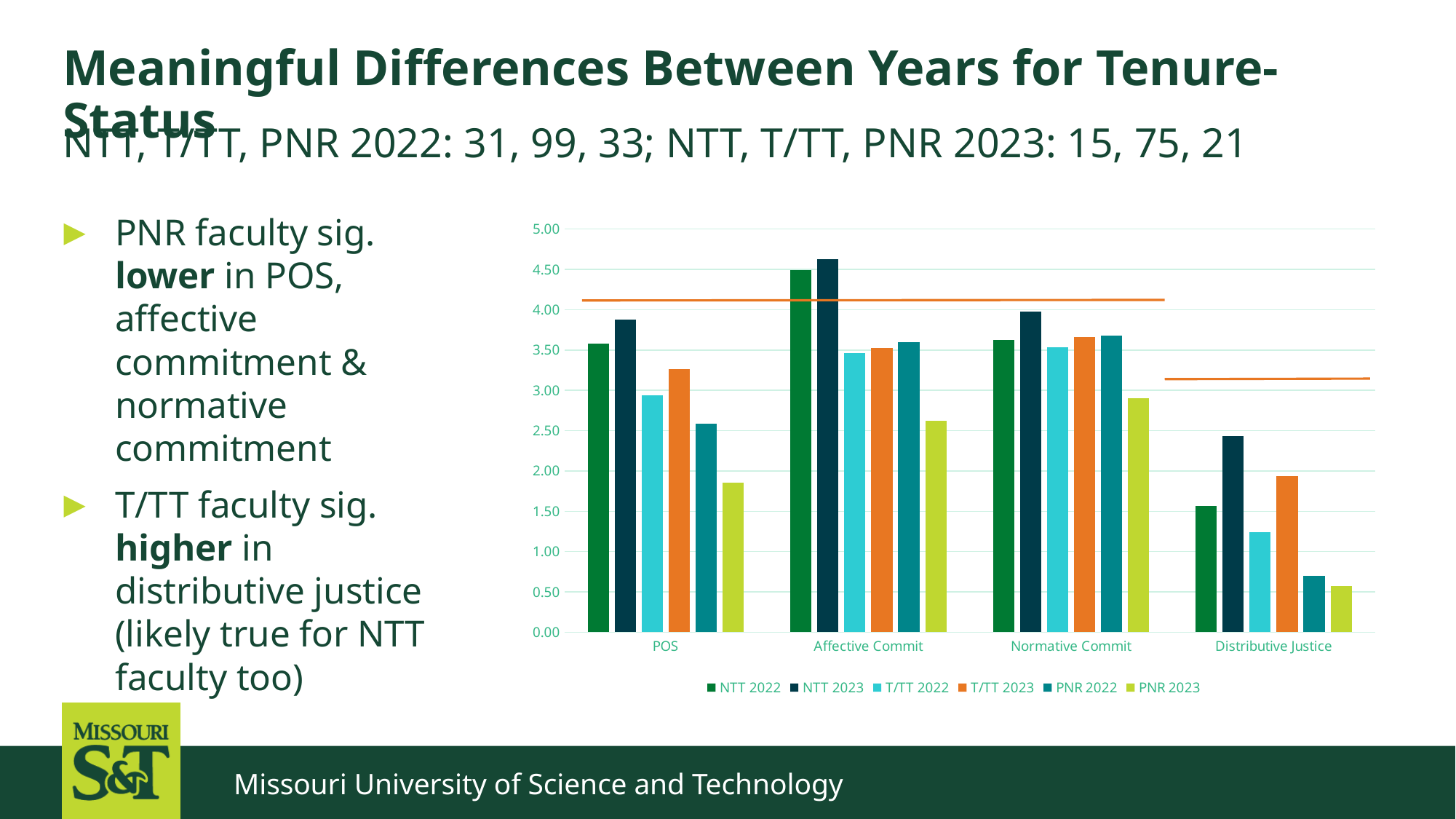
For which category is the NTT 2023 bar the highest? Affective Commit Is the NTT 2023 value for Affective Commit greater or less than 4.50? greater Which series is listed last in the chart's legend? PNR 2023 Is the PNR 2023 value for POS greater or less than 2.00? less Is the NTT 2022 value for POS greater or less than 3.00? greater How many series does the chart's legend list? 6 How many categories are shown along the x axis of the chart? 4 For Distributive Justice, which is larger: the NTT 2023 bar or the T/TT 2023 bar? NTT 2023 What kind of chart is shown on the slide? Bar chart For POS, which is larger: the NTT 2023 bar or the PNR 2022 bar? NTT 2023 For which category is the PNR 2023 bar the lowest? Distributive Justice